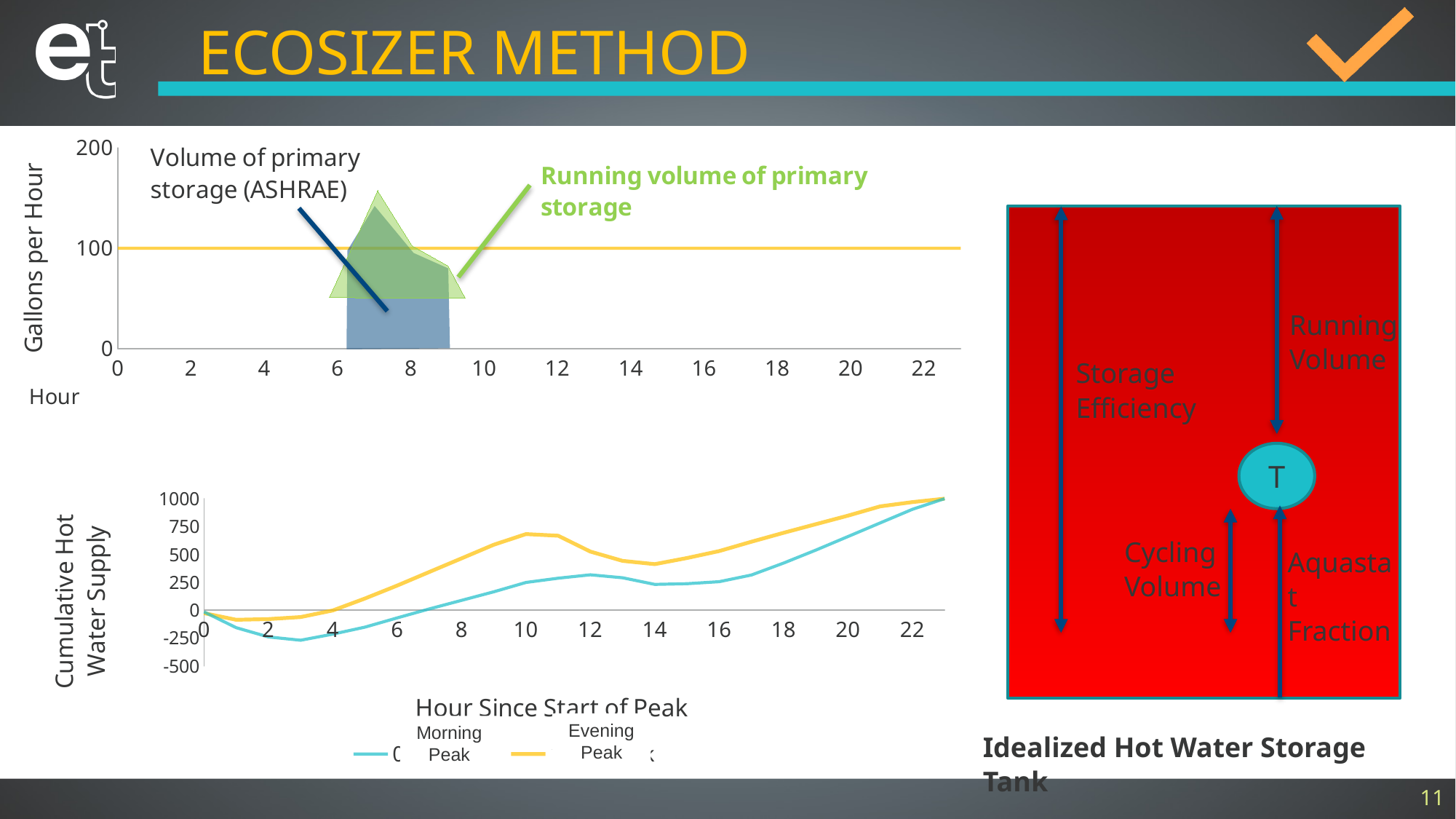
In the top chart (Gallons per Hour), is the peak of the green 'Running volume of primary storage' shape greater or less than 100? greater In the bottom chart (Cumulative Hot Water Supply), is the Evening Peak value at hour 10 greater or less than 500? greater In the bottom chart (Cumulative Hot Water Supply), which series is higher at hour 14, Morning Peak or Evening Peak? Evening Peak In the bottom chart (Cumulative Hot Water Supply), does the Evening Peak series rise or fall between hour 14 and hour 22? rise What is the x-axis title of the bottom chart (Cumulative Hot Water Supply)? Hour Since Start of Peak In the bottom chart (Cumulative Hot Water Supply), which series is higher at hour 10, Morning Peak or Evening Peak? Evening Peak In the bottom chart (Cumulative Hot Water Supply), is the Morning Peak value at hour 20 greater or less than 500? greater What are the two series named in the legend of the bottom chart (Cumulative Hot Water Supply)? Morning Peak and Evening Peak In the top chart (Gallons per Hour), at what value does the horizontal yellow line sit on the y axis? 100 How many series does the legend of the bottom chart (Cumulative Hot Water Supply) list? 2 What kind of chart is the bottom chart (Cumulative Hot Water Supply)? line chart